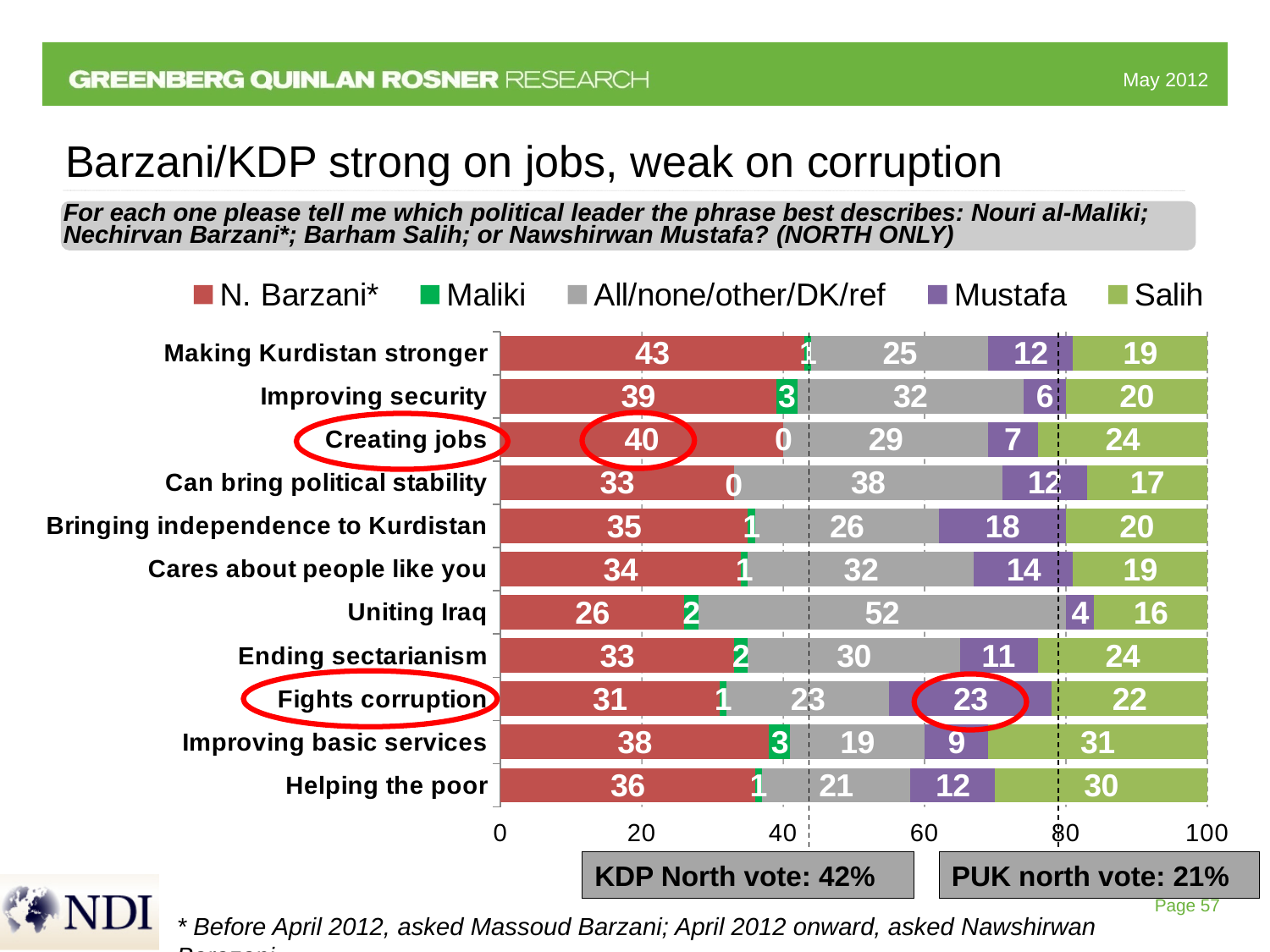
What value is shown for Salih on "Improving basic services"? 31 How many categories are shown on the chart? 11 How many series does the legend list? 5 Which is larger: the Salih value for "Helping the poor" or the Salih value for "Uniting Iraq"? Helping the poor What kind of chart is shown on the slide? Stacked bar chart What value is shown for N. Barzani* on "Creating jobs"? 40 What is the difference between the N. Barzani* value for "Making Kurdistan stronger" and for "Fights corruption"? 12 What value is shown for Mustafa on "Fights corruption"? 23 What is the total of the stacked bar for "Fights corruption"? 100 For which category does N. Barzani* have the lowest value? Uniting Iraq What value is shown for All/none/other/DK/ref on "Uniting Iraq"? 52 For which category does N. Barzani* have the highest value? Making Kurdistan stronger